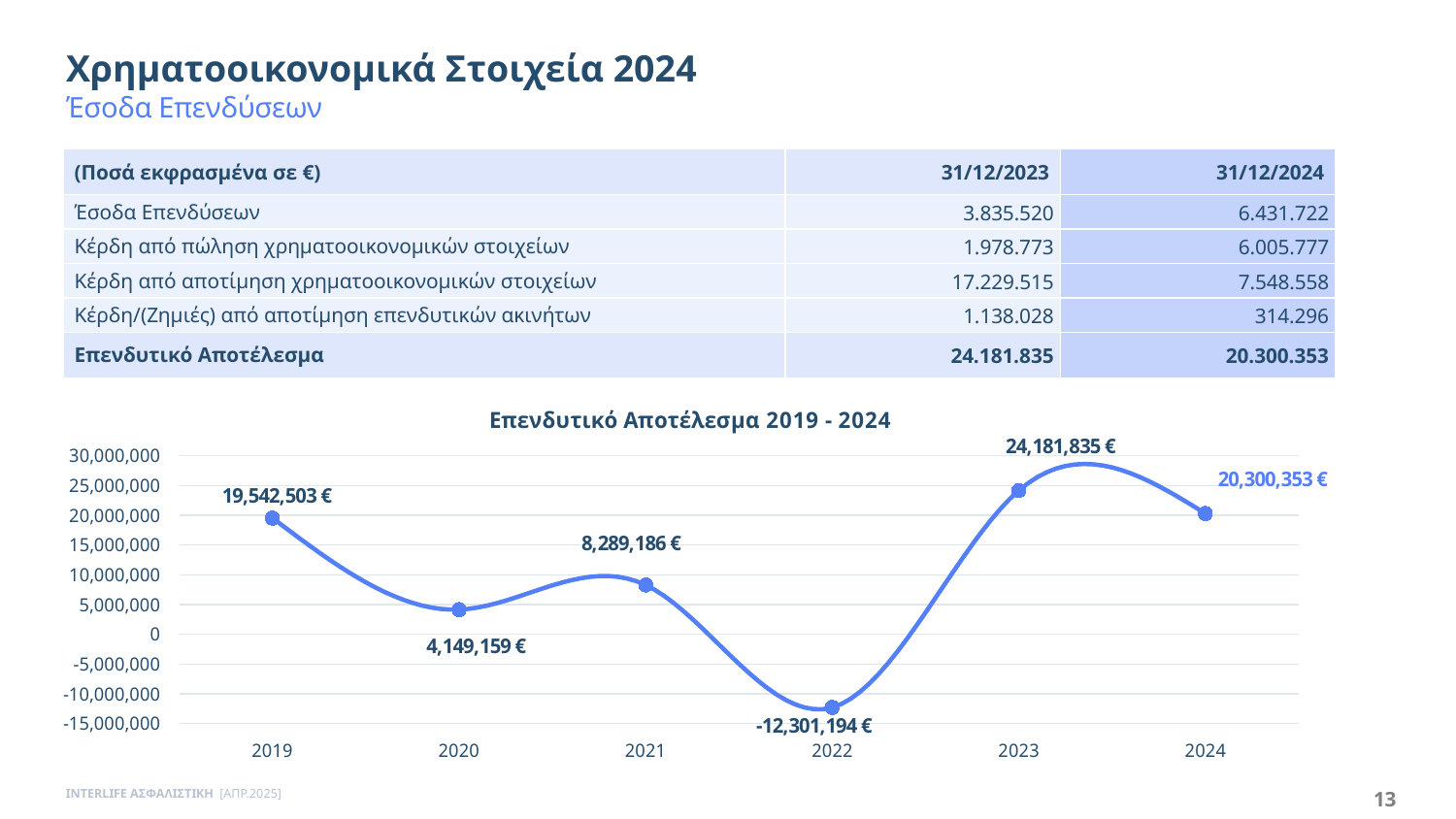
What is the difference between the values for 2023 and 2024? 3,881,482 € Does the value rise or fall from 2023 to 2024? fall How many data points are plotted in the chart? 6 What is the value for 2022 in the chart? -12,301,194 € What is the value for 2024 in the chart? 20,300,353 € What type of chart is shown on the slide? line chart Which year has the lowest value in the chart? 2022 Which is larger, the value for 2020 or the value for 2021? 2021 What is the value for 2019 in the chart? 19,542,503 € What is the title of the chart? Επενδυτικό Αποτέλεσμα 2019 - 2024 What is the difference between the values for 2019 and 2020? 15,393,344 € Which year has the highest value in the chart? 2023